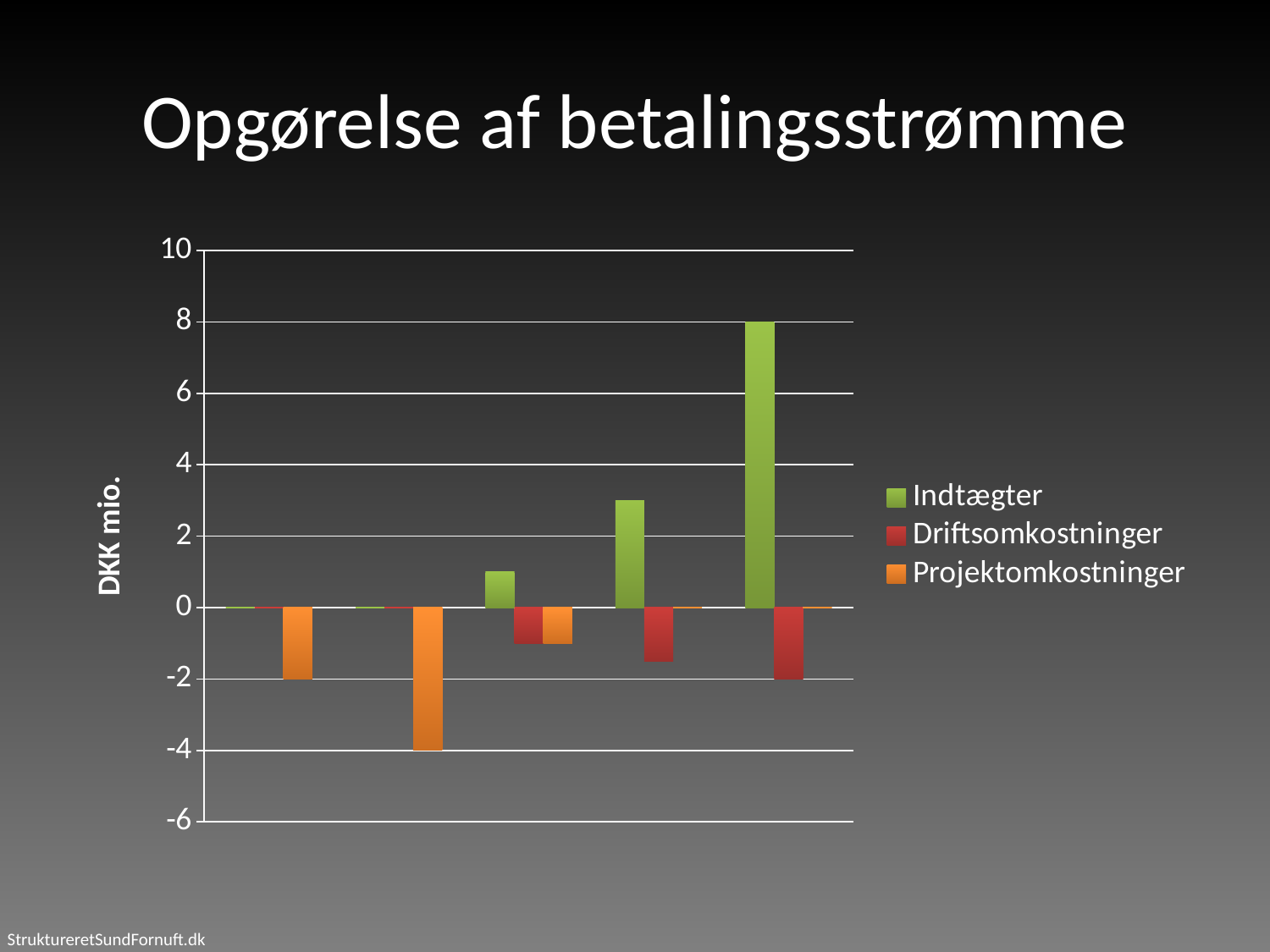
What is the value of Driftsomkostninger in the rightmost group of bars? -2 Which series is shown in green in the legend? Indtægter What is the title of the y axis? DKK mio. What is the value of Indtægter in the rightmost group of bars? 8 How many groups of bars are plotted along the x axis? 5 What kind of chart is shown on the slide? bar chart How many series does the legend list? 3 Do the Indtægter bars rise or fall from left to right along the x axis? rise Is the value of Indtægter in the fourth group of bars from the left greater or less than 2? greater Which series has the highest bar on the chart? Indtægter What is the value of Projektomkostninger in the second group of bars from the left? -4 Which series has the lowest bar on the chart? Projektomkostninger